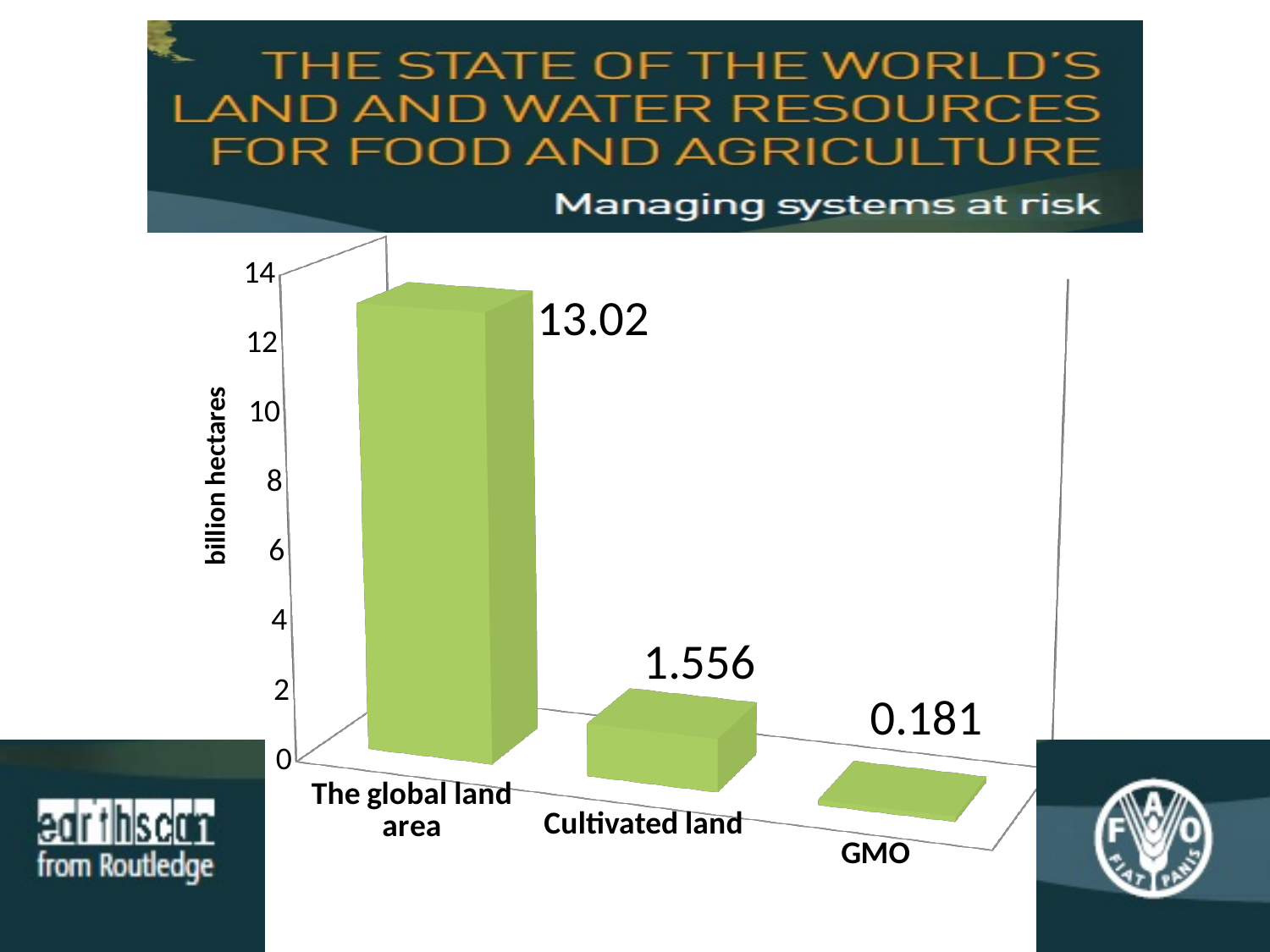
What is the value for GMO? 0.181 Is the value for The global land area greater or less than 12? greater Which is larger, the value for Cultivated land or the value for GMO? Cultivated land What is the value for The global land area? 13.02 What is the value for Cultivated land? 1.556 How many categories are shown in the chart? 3 What is the difference between the values for Cultivated land and GMO? 1.375 Which category has the highest value? The global land area What is the label of the vertical axis? billion hectares What is the difference between the values for The global land area and Cultivated land? 11.464 What kind of chart is shown on the slide? bar chart Which category has the lowest value? GMO